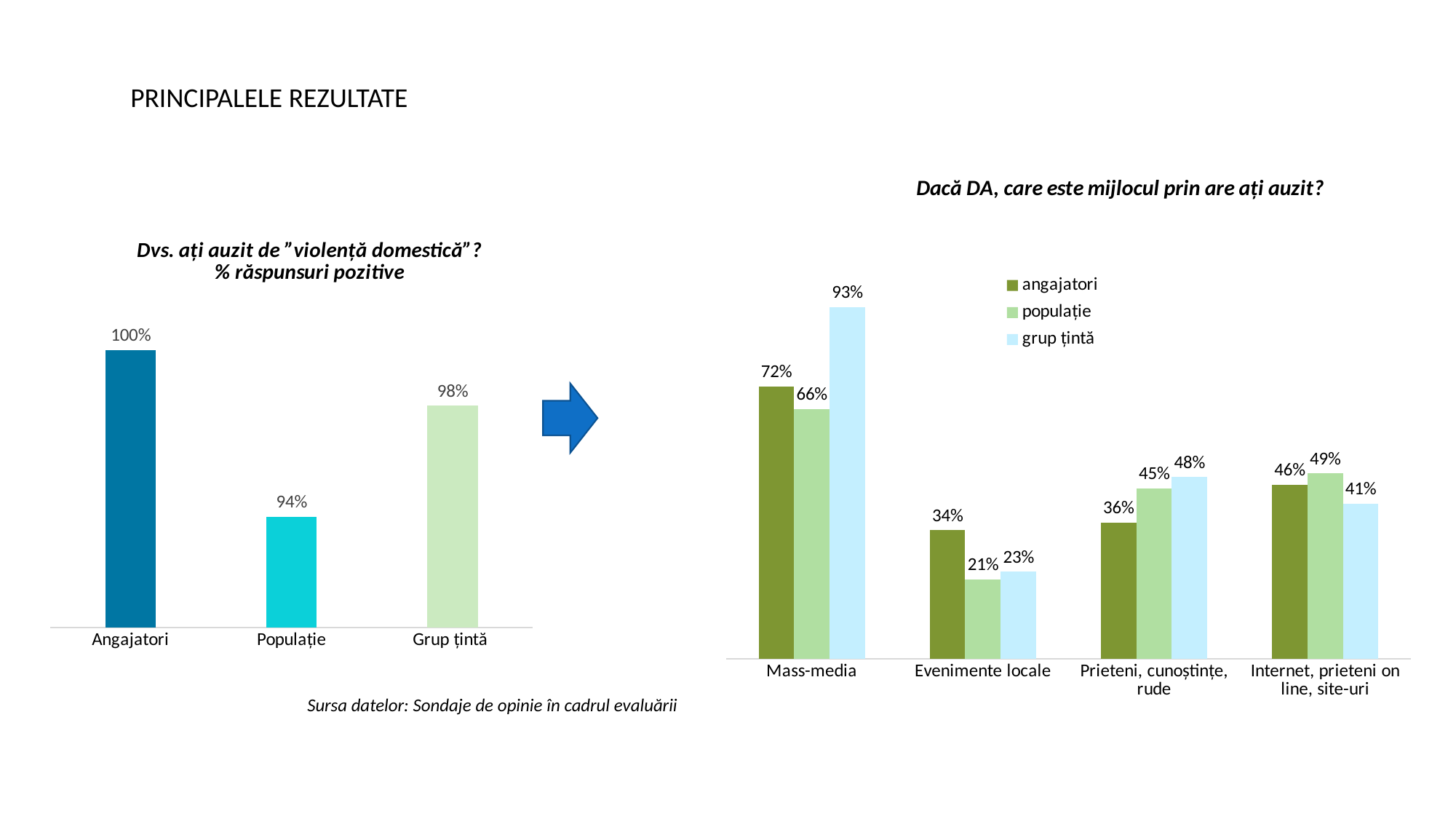
What kind of chart is the right chart ("Dacă DA, care este mijlocul prin are ați auzit?")? Bar chart In the right chart ("Dacă DA, care este mijlocul prin are ați auzit?"), what is the value for grup țintă at Mass-media? 93% In the right chart ("Dacă DA, care este mijlocul prin are ați auzit?"), which series is shown in light blue according to the legend? grup țintă In the right chart ("Dacă DA, care este mijlocul prin are ați auzit?"), what is the difference between angajatori and populație at Mass-media? 6% In the right chart ("Dacă DA, care este mijlocul prin are ați auzit?"), which category has the highest value for angajatori? Mass-media In the right chart ("Dacă DA, care este mijlocul prin are ați auzit?"), what is the value for populație at Evenimente locale? 21% In the right chart ("Dacă DA, care este mijlocul prin are ați auzit?"), which is larger at Internet, prieteni on line, site-uri: populație or grup țintă? populație In the left chart ("Dvs. ați auzit de "violență domestică"?"), what is the value for Populație? 94% In the left chart ("Dvs. ați auzit de "violență domestică"?"), how many categories are shown? 3 In the left chart ("Dvs. ați auzit de "violență domestică"?"), which category has the lowest value? Populație In the left chart ("Dvs. ați auzit de "violență domestică"?"), what is the difference between Angajatori and Grup țintă? 2% In the right chart ("Dacă DA, care este mijlocul prin are ați auzit?"), how many series does the legend list? 3